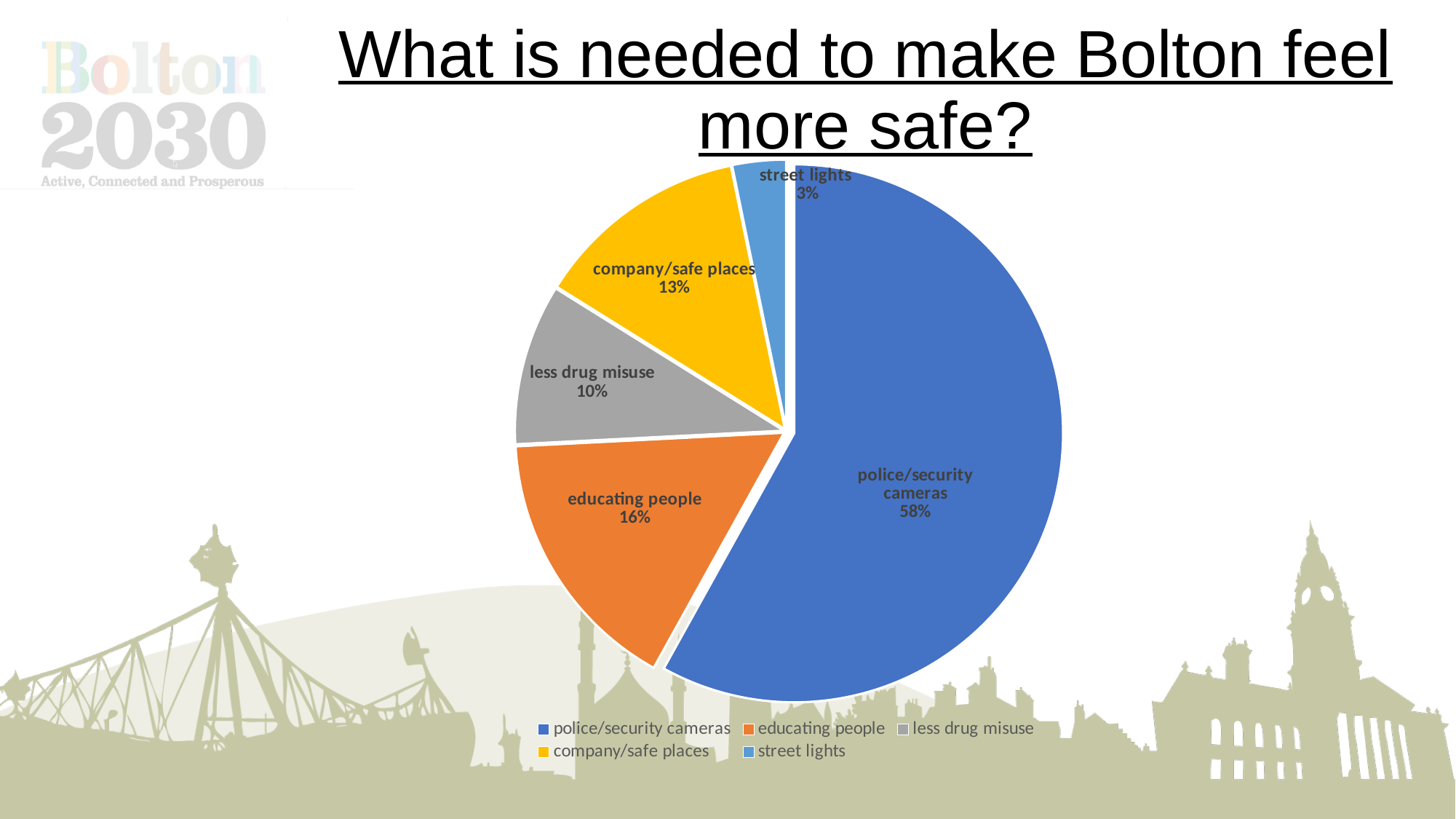
What is the value for company/safe places? 13% Which category has the largest slice? police/security cameras What share of the pie is police/security cameras? 58% How many categories are shown in the pie chart? 5 What is the difference between police/security cameras and educating people? 42% Which category has the smallest slice? street lights Which is larger, company/safe places or less drug misuse? company/safe places What is the title of the slide? What is needed to make Bolton feel more safe? What is the value for street lights? 3% What kind of chart is shown on the slide? pie chart What is the value for less drug misuse? 10% What is the value for educating people? 16%